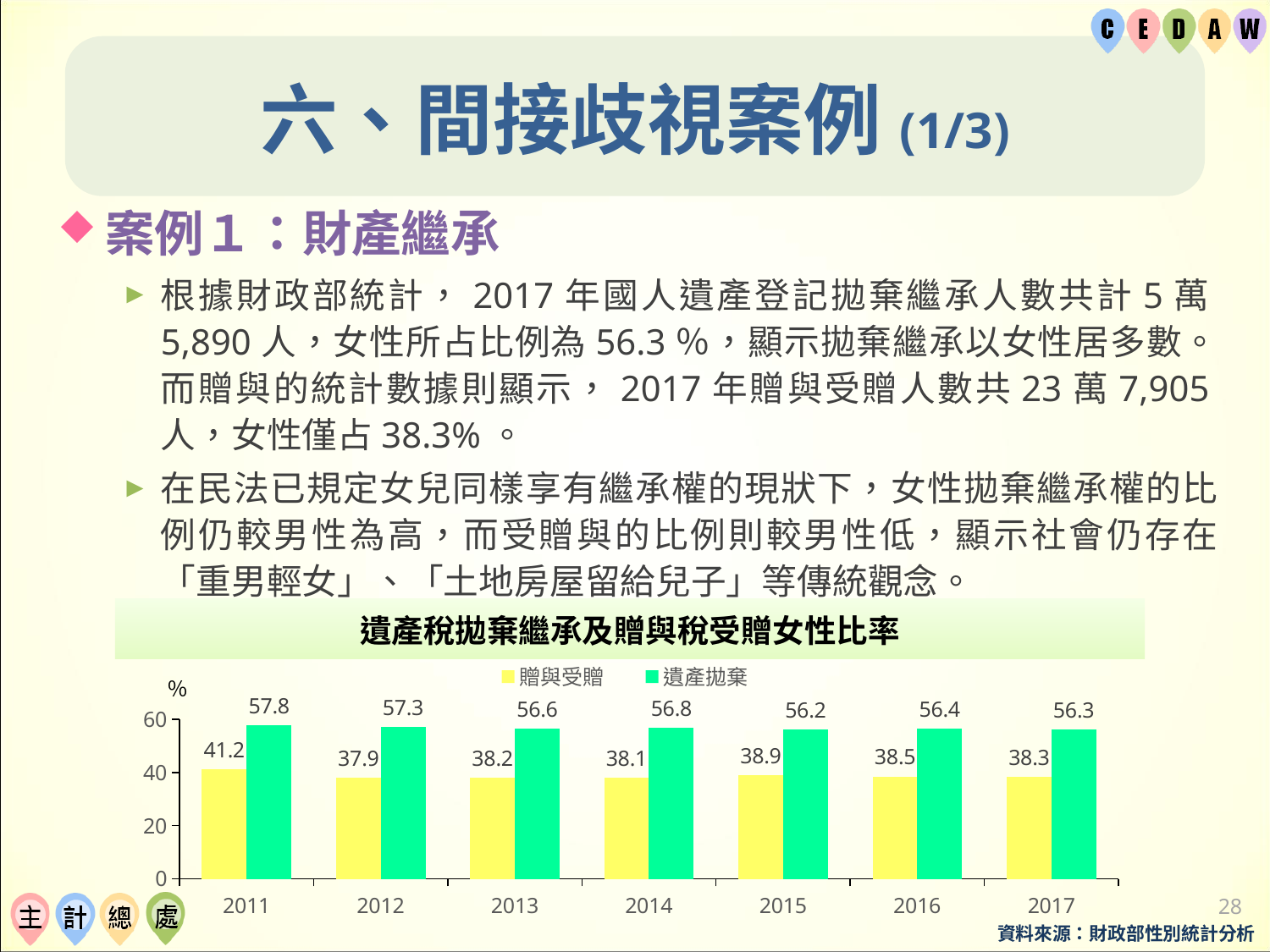
How many series does the chart legend list? 2 What is the value for 遺產拋棄 in 2014? 56.8 Is the 贈與受贈 value for 2013 greater or less than 40? less What is the difference between the 遺產拋棄 and 贈與受贈 values in 2017? 18 What is the title of the chart? 遺產稅拋棄繼承及贈與稅受贈女性比率 What is the value for 遺產拋棄 in 2017? 56.3 How many years are shown on the x axis of the chart? 7 What kind of chart is shown on the slide? bar chart In which year is the 贈與受贈 value lowest? 2012 What is the value for 贈與受贈 in 2011? 41.2 Which is larger in 2015, the 贈與受贈 value or the 遺產拋棄 value? 遺產拋棄 In which year is the 遺產拋棄 value highest? 2011